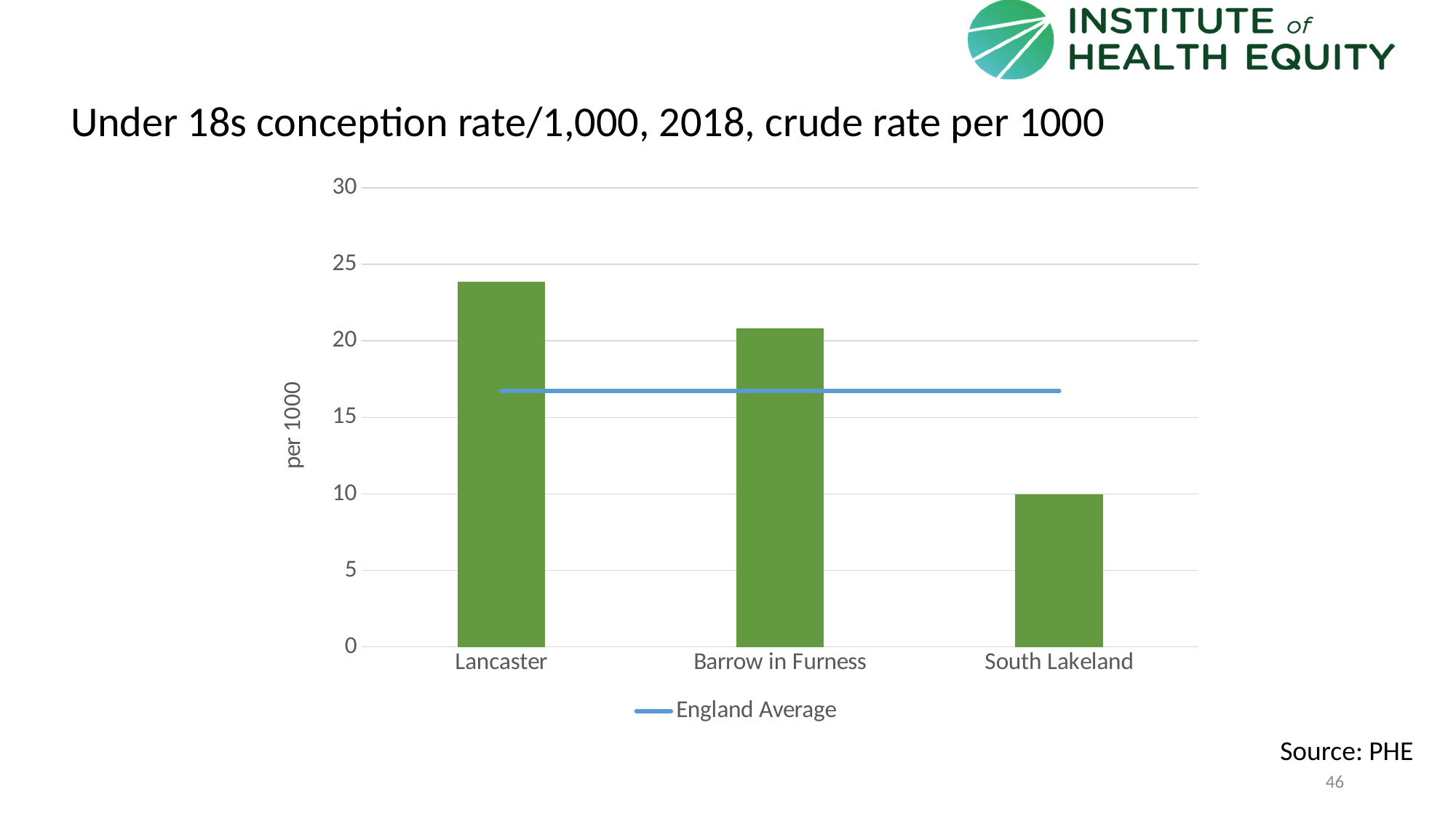
Do the bar values rise or fall from left to right across the chart? fall Is the value for Barrow in Furness above or below the England Average line? above Which area has the lowest under 18s conception rate? South Lakeland Which has the higher conception rate, Lancaster or Barrow in Furness? Lancaster Is the England Average line greater or less than 15? greater How many local areas are plotted as bars on the chart? 3 Is the value for Barrow in Furness greater or less than 25? less Is the value for Lancaster greater or less than 20? greater What kind of chart is shown on the slide? bar chart Which area has the highest under 18s conception rate? Lancaster What entry does the chart legend list? England Average